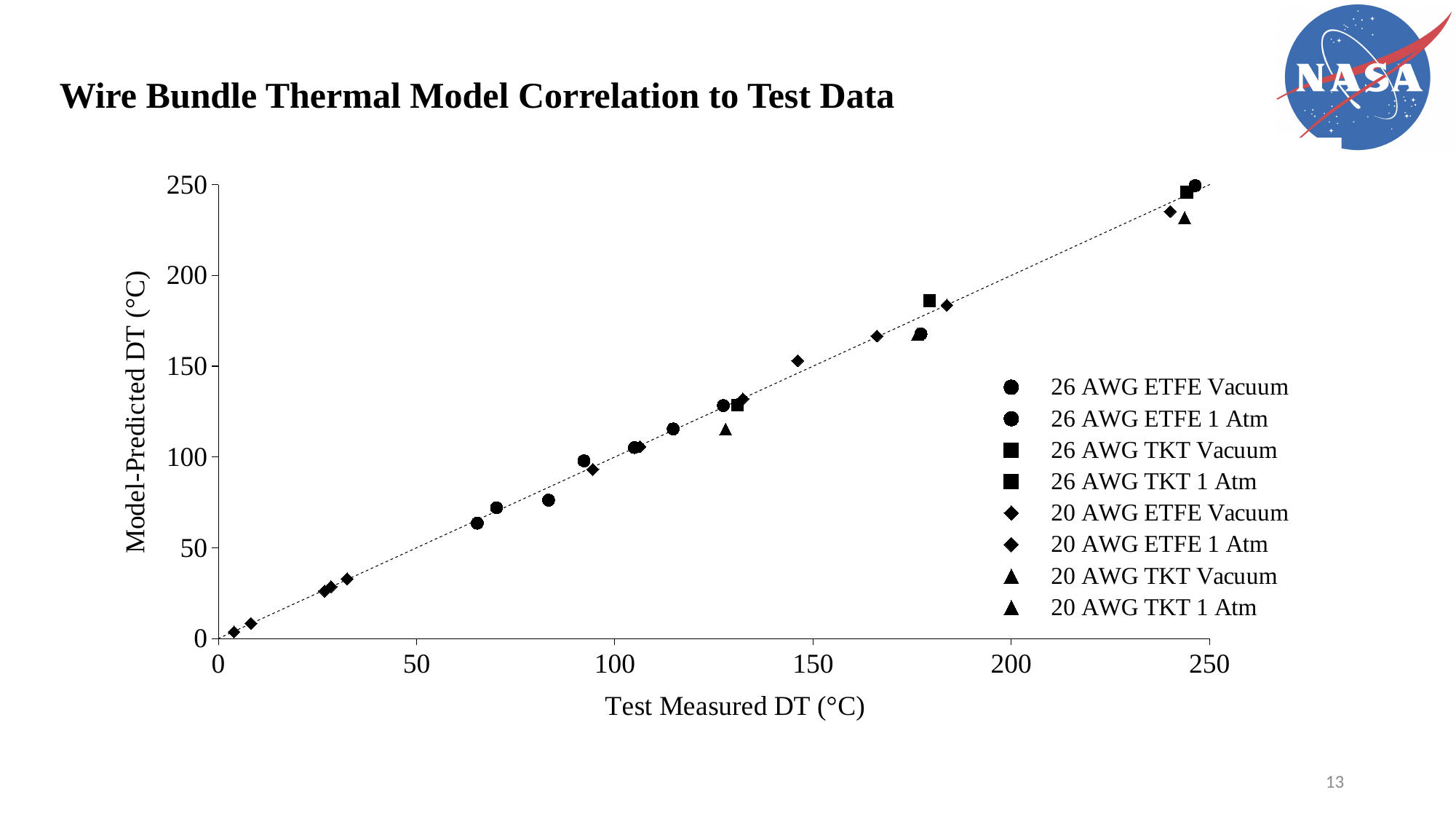
What is the maximum value shown on the y axis (Model-Predicted DT)? 250 Do the Model-Predicted DT values rise or fall as Test Measured DT increases along the x axis? rise Is the lowest Model-Predicted DT value plotted greater or less than 50? less What kind of chart is shown on the slide? scatter chart Which marker shape is used for the 20 AWG TKT series in the legend? triangle What is the title of the chart? Wire Bundle Thermal Model Correlation to Test Data How many series does the legend list? 8 Is the highest Model-Predicted DT value plotted greater or less than 200? greater What is the maximum value shown on the x axis (Test Measured DT)? 250